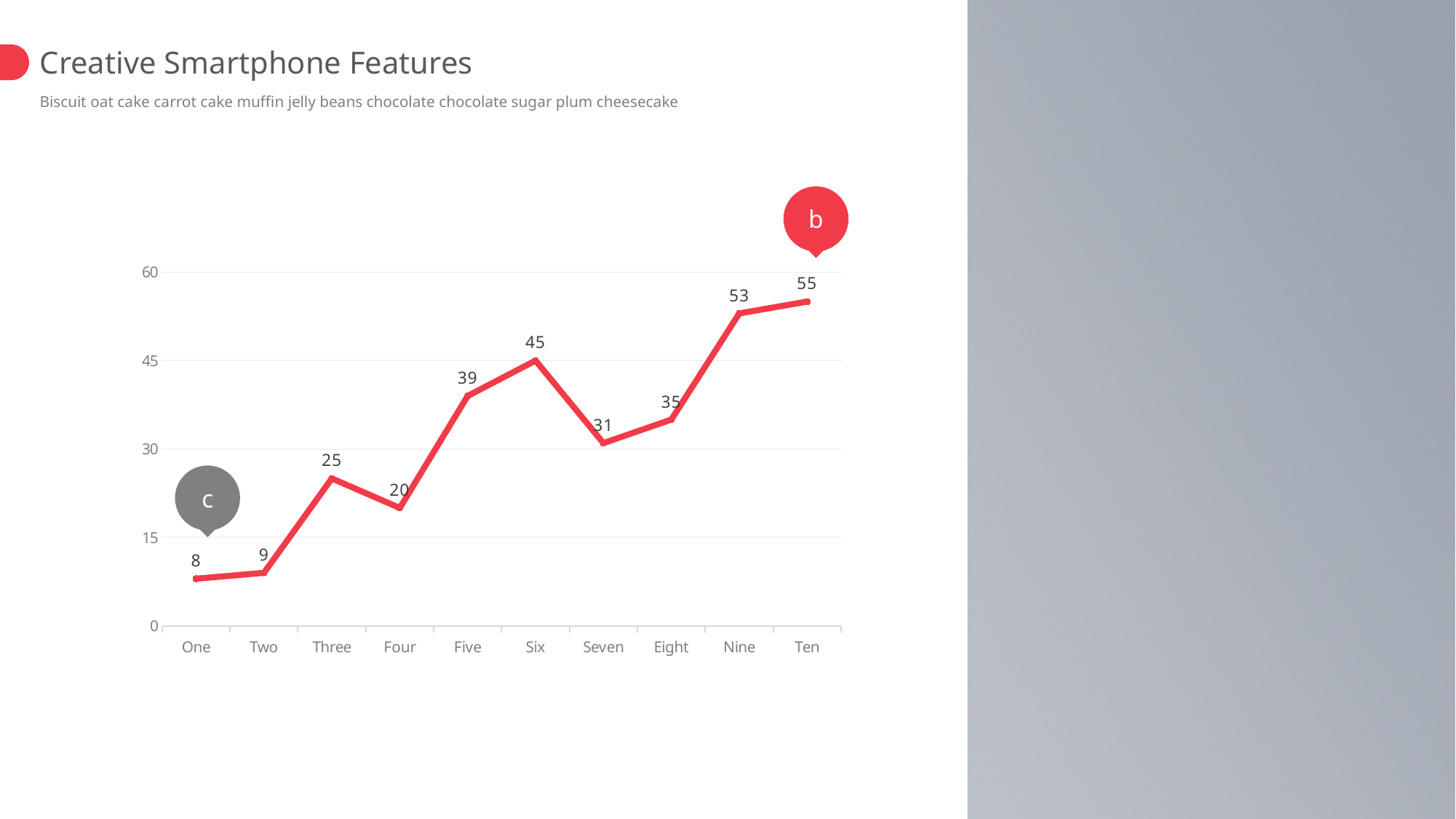
How many categories are shown on the x axis? 10 What is the value for Four? 20 What is the difference between the values for Six and Seven? 14 What is the difference between the values for Ten and Nine? 2 Is the value for Five greater or less than 30? greater What is the value for Nine? 53 Which category has the lowest value? One Which is larger, the value for Three or the value for Four? Three What kind of chart is shown on the slide? line chart What is the value for Six? 45 Which category has the highest value? Ten Do the values generally rise or fall from One to Ten? rise